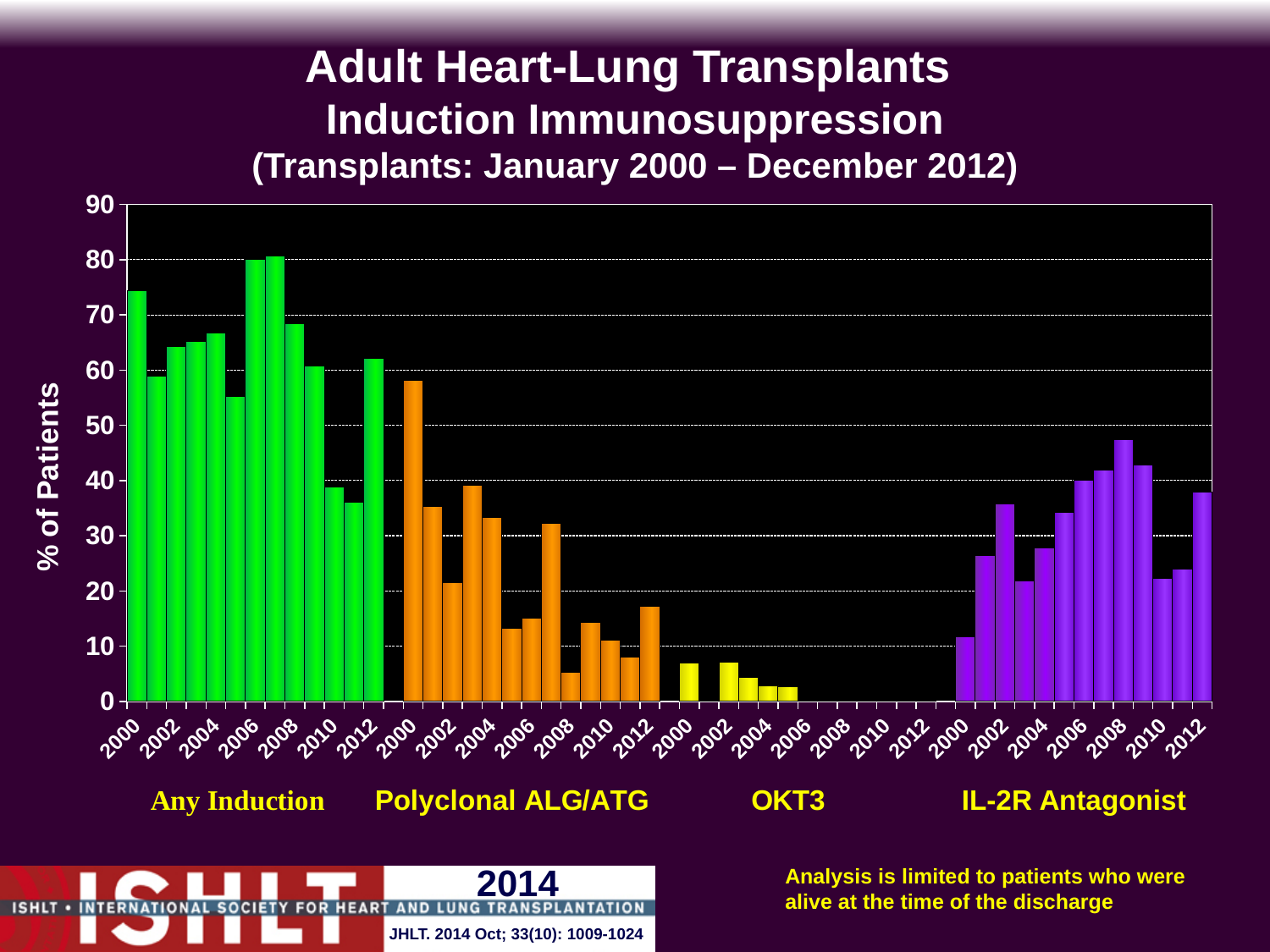
In which year is the Any Induction percentage lowest? 2011 Is the value for OKT3 in 2000 greater or less than 10? less In which year is the IL-2R Antagonist percentage highest? 2008 In 2008, which is larger: the IL-2R Antagonist percentage or the Polyclonal ALG/ATG percentage? IL-2R Antagonist How many induction agent groups are shown along the x axis? 4 Is the value for Any Induction in 2000 greater or less than 70? greater Do the OKT3 values rise or fall from 2002 to 2005? fall Is the value for Polyclonal ALG/ATG in 2000 greater or less than 50? greater What kind of chart is shown on the slide? Bar chart What is the label on the y axis? % of Patients Which induction group is plotted with green bars? Any Induction